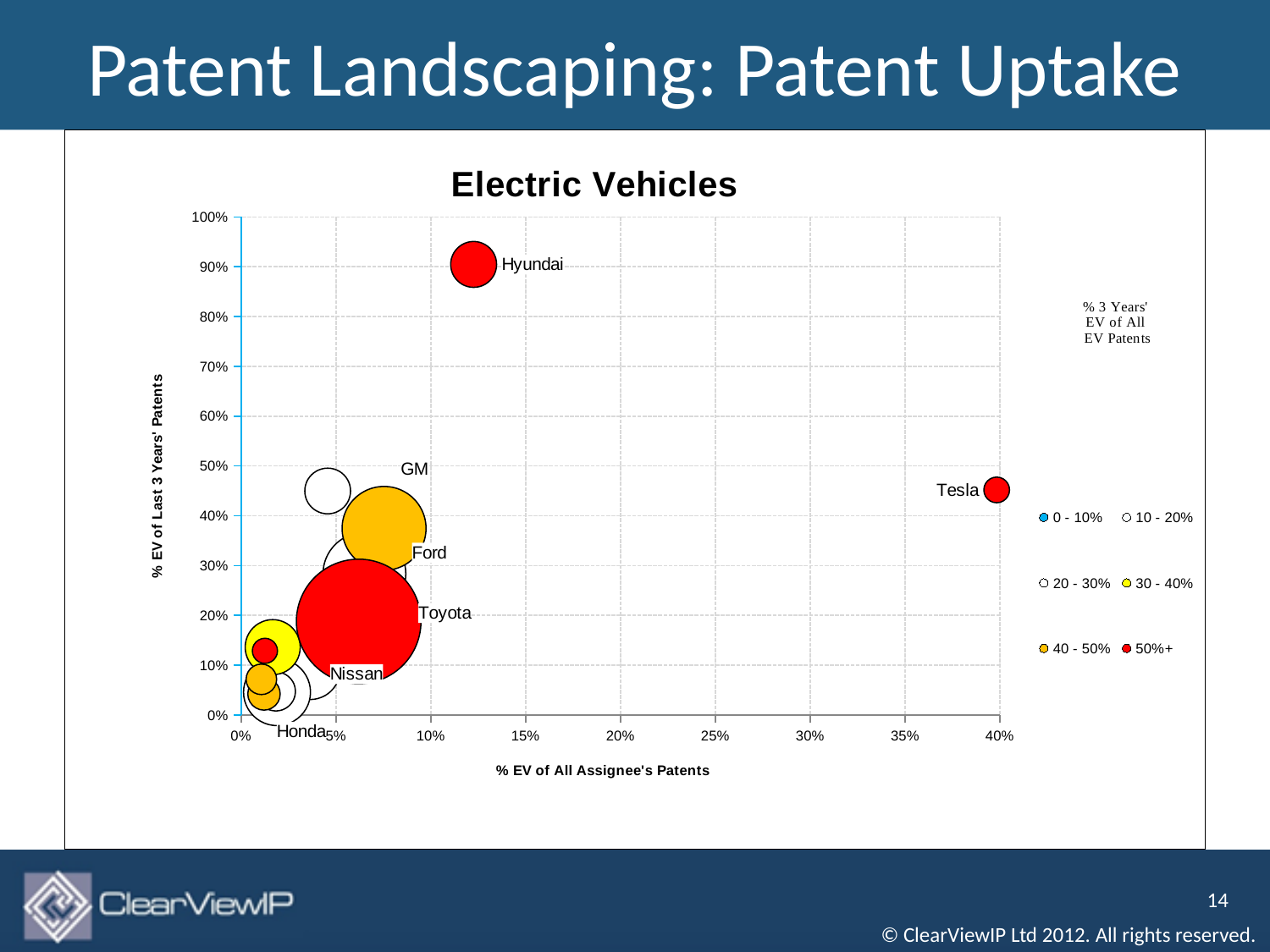
Is the % EV of Last 3 Years' Patents for Hyundai greater or less than 80%? greater Which has a higher % EV of Last 3 Years' Patents, Hyundai or Toyota? Hyundai What is the title of the chart? Electric Vehicles How many entries does the chart's legend list? 6 Is the % EV of All Assignee's Patents for Tesla greater or less than 30%? greater Which has a higher % EV of All Assignee's Patents, Tesla or Hyundai? Tesla Which company has the highest % EV of All Assignee's Patents? Tesla What is the title of the x axis? % EV of All Assignee's Patents What kind of chart is shown on the slide? bubble chart How many companies are labeled on the chart? 7 Which company has the highest % EV of Last 3 Years' Patents? Hyundai Is the % EV of Last 3 Years' Patents for Toyota greater or less than 30%? less